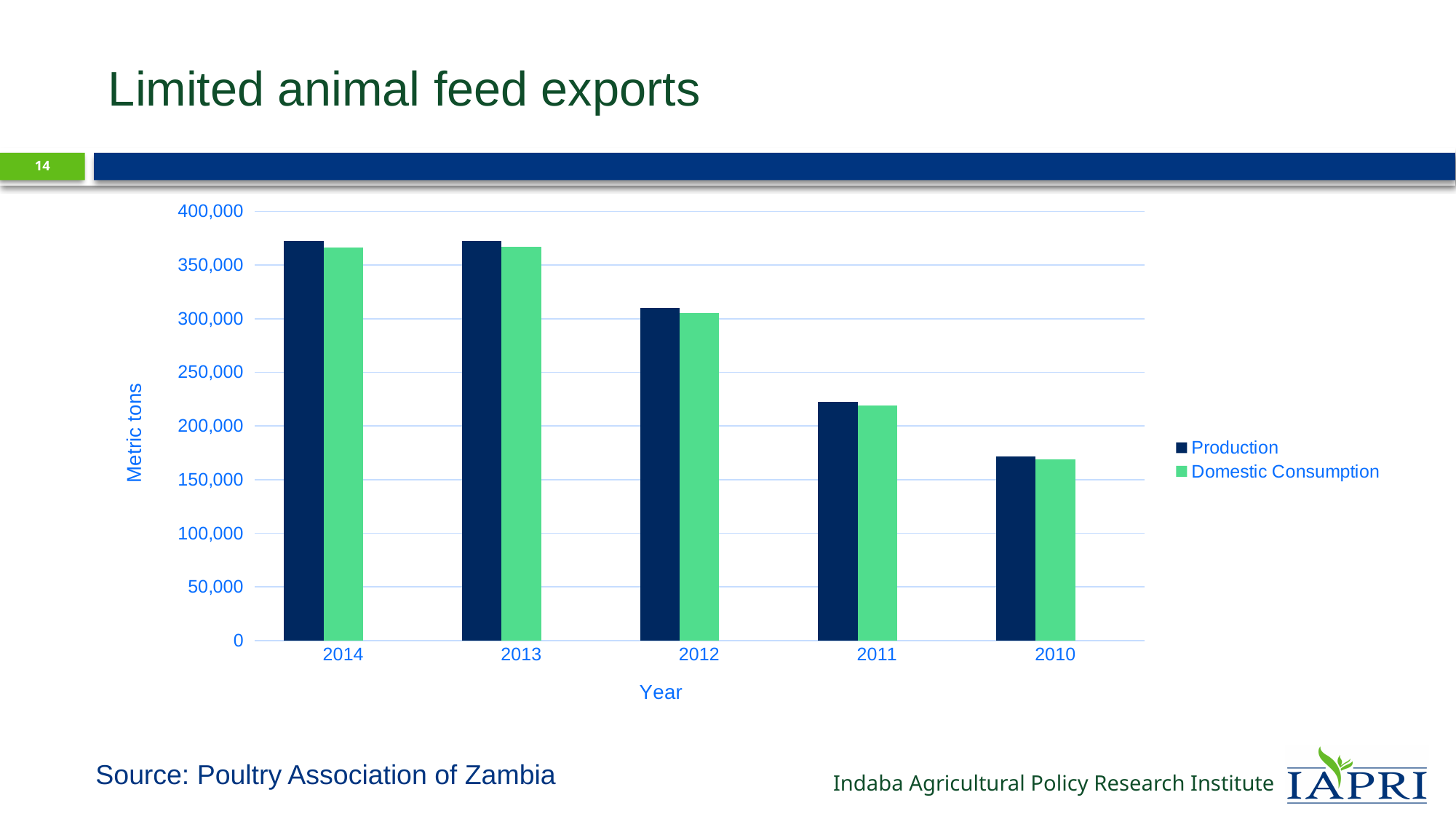
Which year has the lowest Domestic Consumption value? 2010 What is the label of the y axis? Metric tons Is the Production value for 2011 greater or less than 200,000? greater Is the Production value for 2010 greater or less than 200,000? less Which is larger, the Production value for 2012 or the Production value for 2011? 2012 Which year has the lowest Production value? 2010 What kind of chart is shown on the slide? bar chart How many series does the legend list? 2 Is the Production value for 2014 greater or less than 400,000? less How many years are shown on the x axis? 5 Do the Production values rise or fall moving from left to right along the x axis? fall